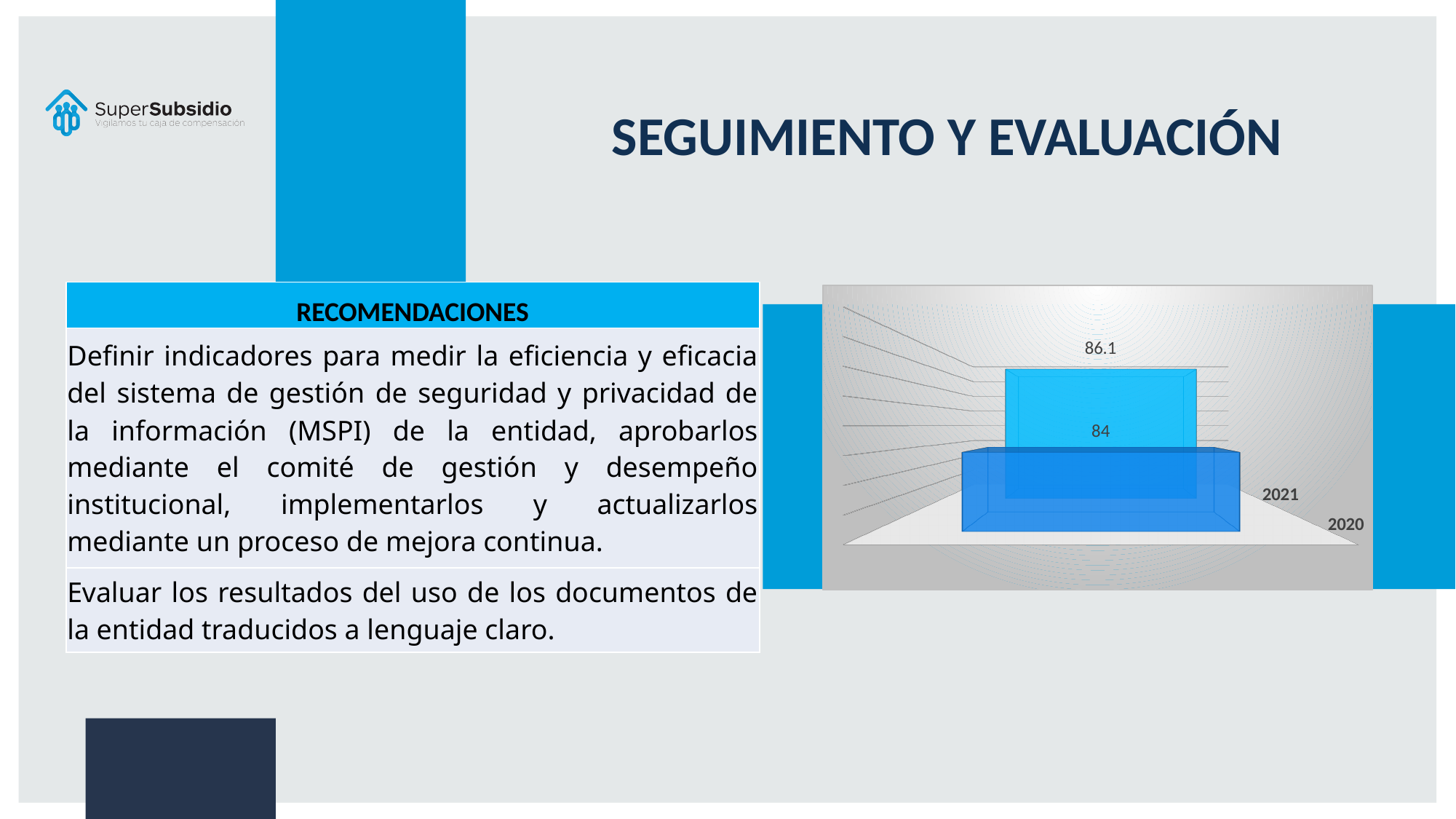
How many categories (years) does the chart show? 2 Which year has the higher value in the chart? 2021 Do the values rise or fall from 2020 to 2021? rise Is the value for 2021 larger or smaller than the value for 2020? larger What is the value for 2020 in the chart? 84 What is the difference between the values for 2021 and 2020? 2.1 Which year has the lower value in the chart? 2020 Which years are shown as categories in the chart? 2020 and 2021 What kind of chart is shown on the right of the slide? bar chart What is the highest value labelled in the chart? 86.1 What is the value for 2021 in the chart? 86.1